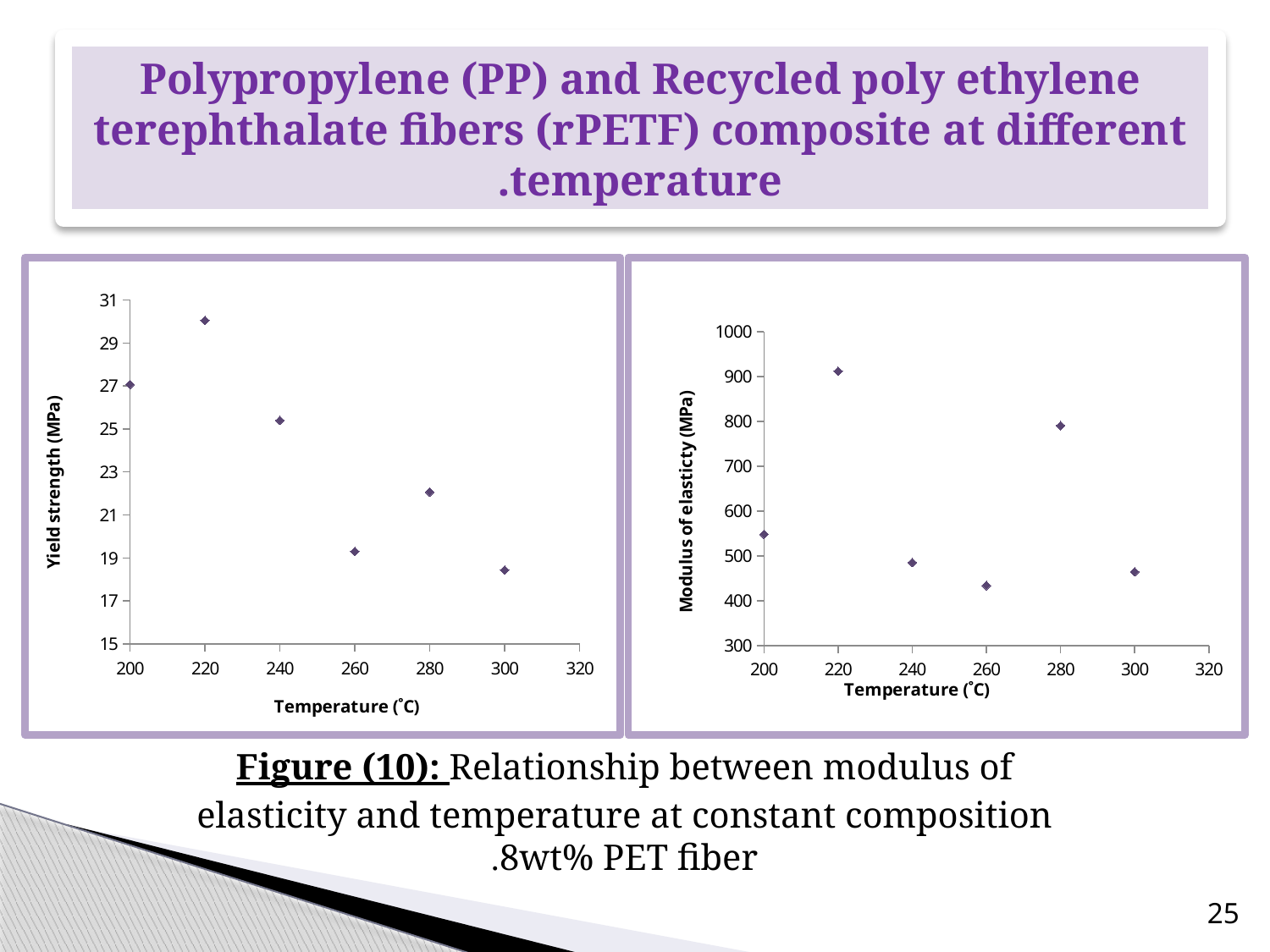
What is the y-axis label of the right chart? Modulus of elasticity (MPa) What kind of chart is the left chart (Yield strength vs Temperature)? scatter chart In the right chart (Modulus of elasticity), at which temperature is the modulus of elasticity lowest? 260 In the right chart (Modulus of elasticity), is the value at 220 °C greater or less than 800? greater In the left chart (Yield strength), at which temperature is the yield strength lowest? 300 In the right chart (Modulus of elasticity), is the value at 240 °C greater or less than 600? less In the left chart (Yield strength), is the value at 260 °C greater or less than 21? less In the left chart (Yield strength), which has the larger yield strength, 240 °C or 280 °C? 240 °C In the left chart (Yield strength), how many data points are plotted? 6 In the left chart (Yield strength), at which temperature is the yield strength highest? 220 In the right chart (Modulus of elasticity), at which temperature is the modulus of elasticity highest? 220